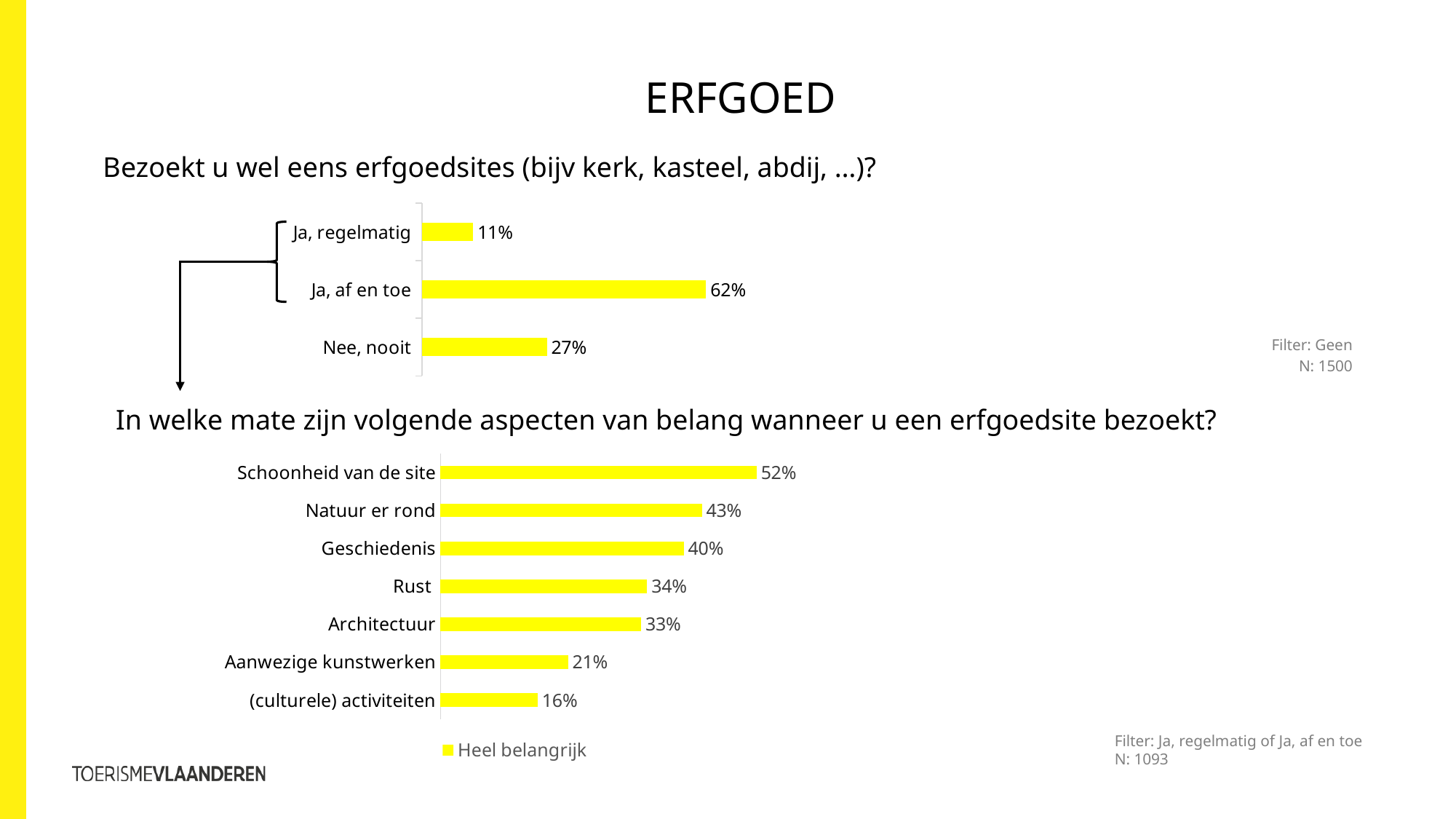
In the bottom chart (In welke mate zijn volgende aspecten van belang), which is larger: 'Natuur er rond' or 'Rust'? Natuur er rond In the top chart (Bezoekt u wel eens erfgoedsites), how many categories are shown? 3 What type of chart is the bottom chart (In welke mate zijn volgende aspecten van belang)? Bar chart In the bottom chart (In welke mate zijn volgende aspecten van belang), which aspect has the highest value? Schoonheid van de site In the top chart (Bezoekt u wel eens erfgoedsites), what is the value for 'Ja, af en toe'? 62% In the bottom chart (In welke mate zijn volgende aspecten van belang), which aspect has the lowest value? (culturele) activiteiten In the bottom chart (In welke mate zijn volgende aspecten van belang), how many aspects are listed? 7 In the top chart (Bezoekt u wel eens erfgoedsites), which category has the lowest value? Ja, regelmatig In the bottom chart (In welke mate zijn volgende aspecten van belang), what is the value for 'Geschiedenis'? 40% In the top chart (Bezoekt u wel eens erfgoedsites), what is the difference between 'Nee, nooit' and 'Ja, regelmatig'? 16% In the bottom chart (In welke mate zijn volgende aspecten van belang), what is the difference between 'Schoonheid van de site' and 'Aanwezige kunstwerken'? 31% In the bottom chart (In welke mate zijn volgende aspecten van belang), what series does the legend list? Heel belangrijk